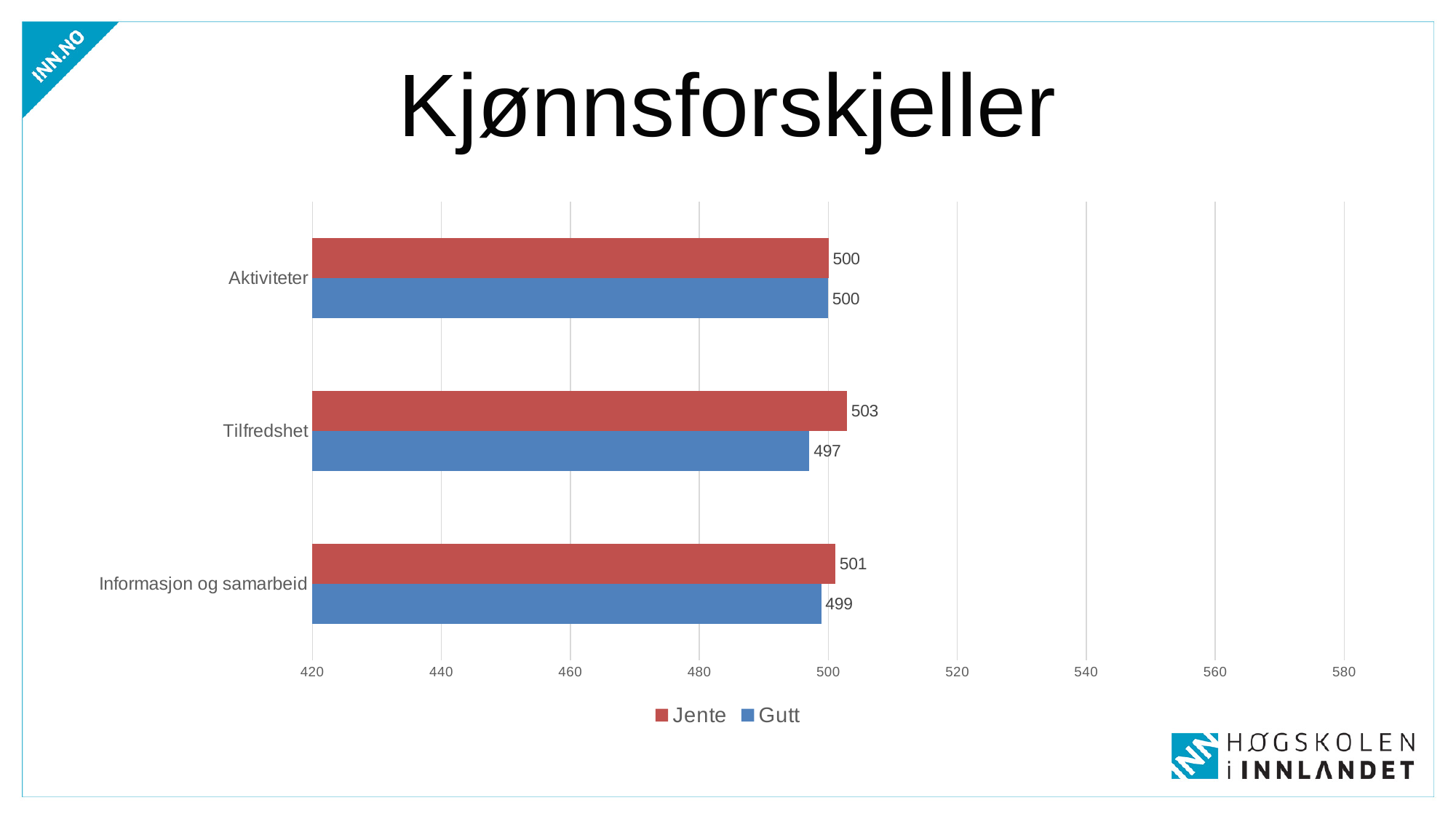
Which category has the highest value for Jente? Tilfredshet What is the value for Jente in the Informasjon og samarbeid category? 501 What is the difference between the Jente and Gutt values for Tilfredshet? 6 What is the value for Gutt in the Aktiviteter category? 500 Which category has the lowest value for Gutt? Tilfredshet How many series does the legend list? 2 What is the value for Gutt in the Tilfredshet category? 497 What is the value for Jente in the Tilfredshet category? 503 Which is larger for Informasjon og samarbeid, the Jente value or the Gutt value? Jente How many categories are shown on the chart? 3 What type of chart is shown on the slide? Bar chart What is the value for Gutt in the Informasjon og samarbeid category? 499